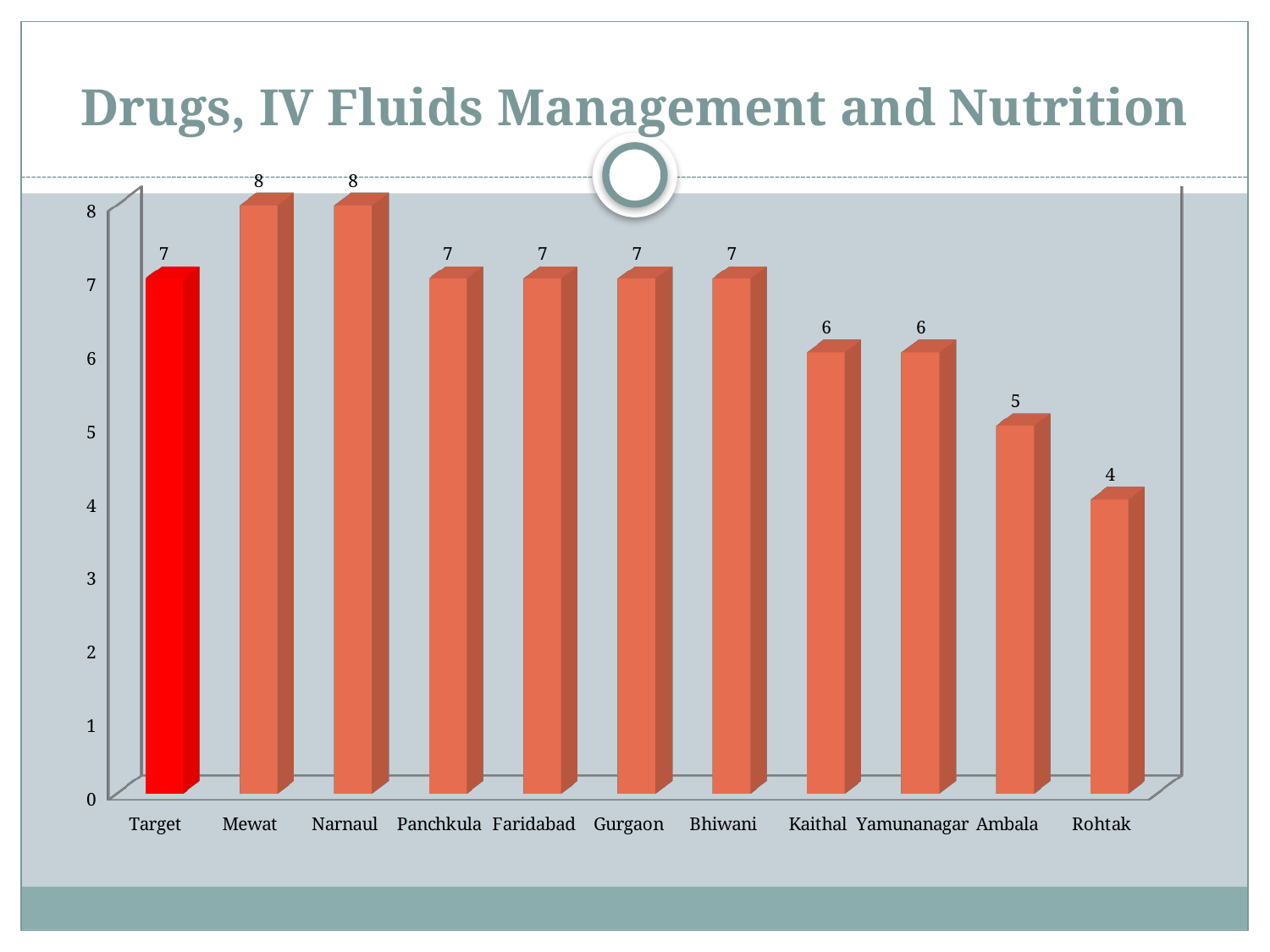
What is the difference between the values for Mewat and Rohtak? 4 What is the value for Ambala? 5 What is the value for Kaithal? 6 What is the value for Target? 7 How many categories are shown on the x axis? 11 Which is larger, the value for Narnaul or the value for Yamunanagar? Narnaul What kind of chart is shown on the slide? Bar chart Which is larger, the value for Rohtak or the value for Kaithal? Kaithal What is the value for Rohtak? 4 What is the difference between the values for Target and Ambala? 2 What is the title of the slide? Drugs, IV Fluids Management and Nutrition Which category has the lowest value? Rohtak